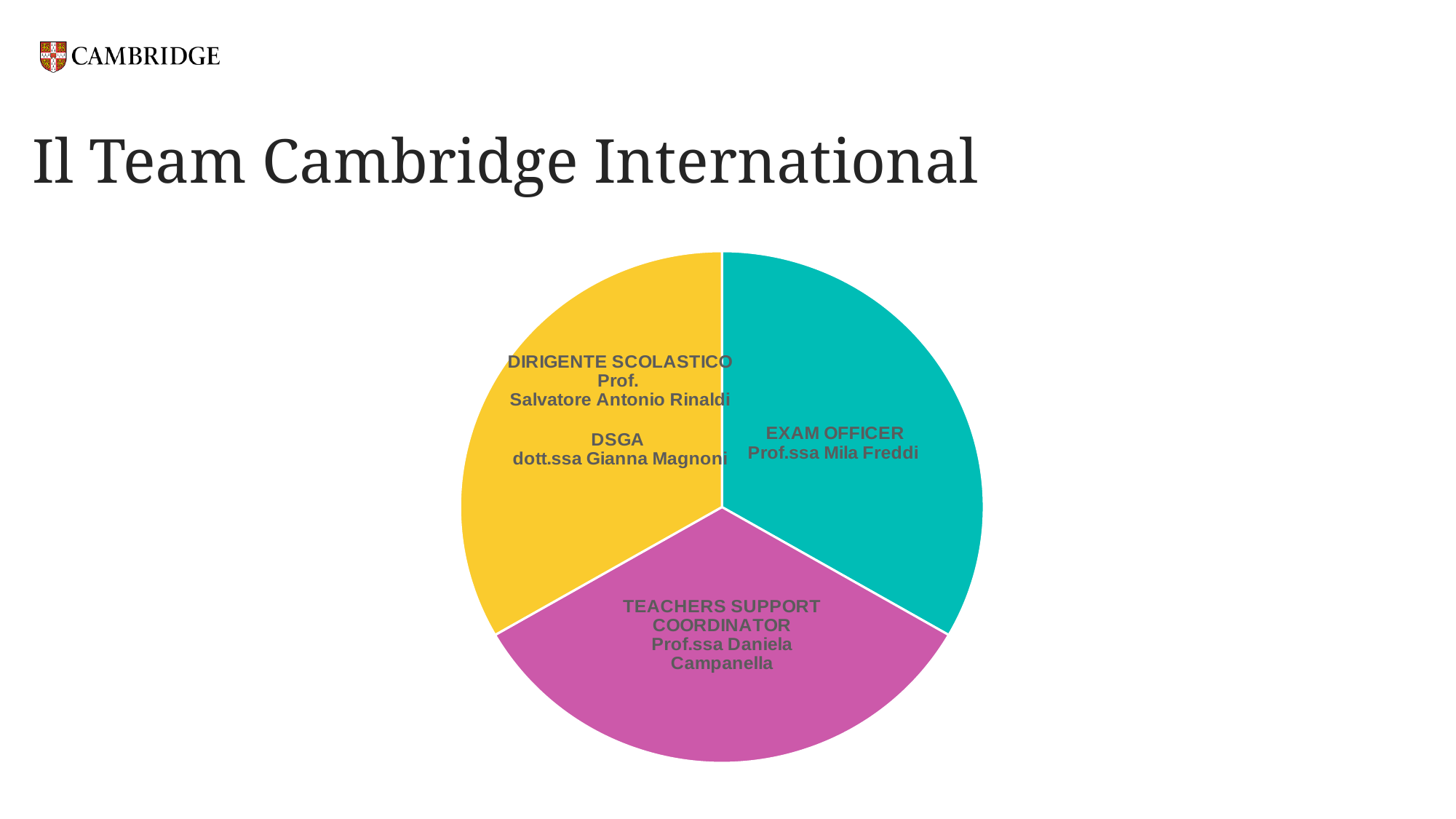
Who is named as the DSGA in the pie chart? dott.ssa Gianna Magnoni Which role is labelled on the teal slice of the pie chart? EXAM OFFICER Who is named as the Dirigente Scolastico in the pie chart? Prof. Salvatore Antonio Rinaldi What kind of chart is shown on the slide? pie chart What is the title of the slide containing the pie chart? Il Team Cambridge International How many slices does the pie chart have? 3 Who is named as the Teachers Support Coordinator in the pie chart? Prof.ssa Daniela Campanella Who is named as the Exam Officer in the pie chart? Prof.ssa Mila Freddi